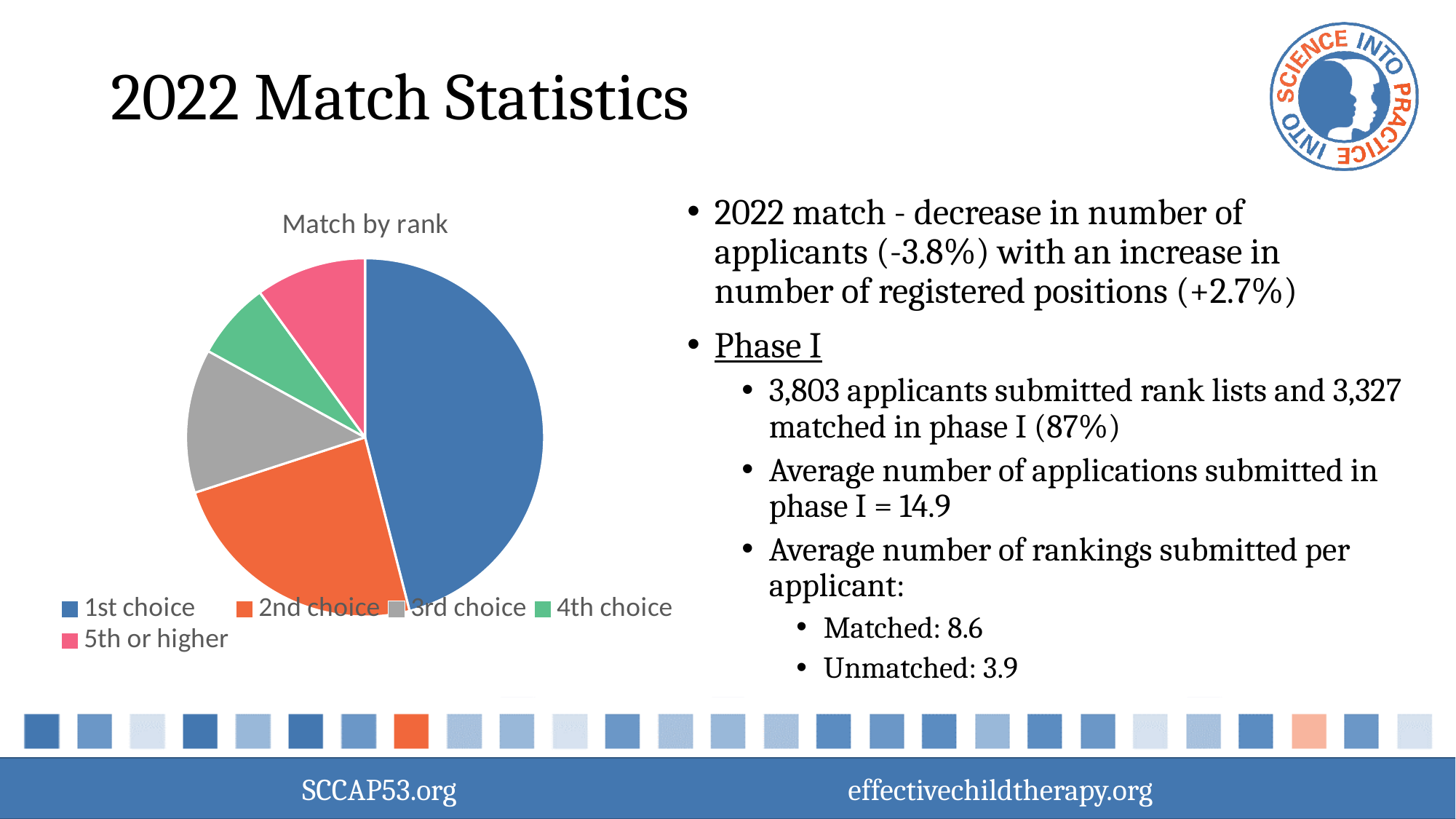
What is the title of the pie chart? Match by rank Which slice is larger, 1st choice or 2nd choice? 1st choice How many slices does the pie chart have? 5 Which slice is larger, 2nd choice or 5th or higher? 2nd choice Which slice is larger, 3rd choice or 5th or higher? 3rd choice Which category has the largest slice in the pie chart? 1st choice What colour is the 1st choice slice in the pie chart? blue How many entries does the legend of the pie chart list? 5 What kind of chart is shown on the slide? pie chart